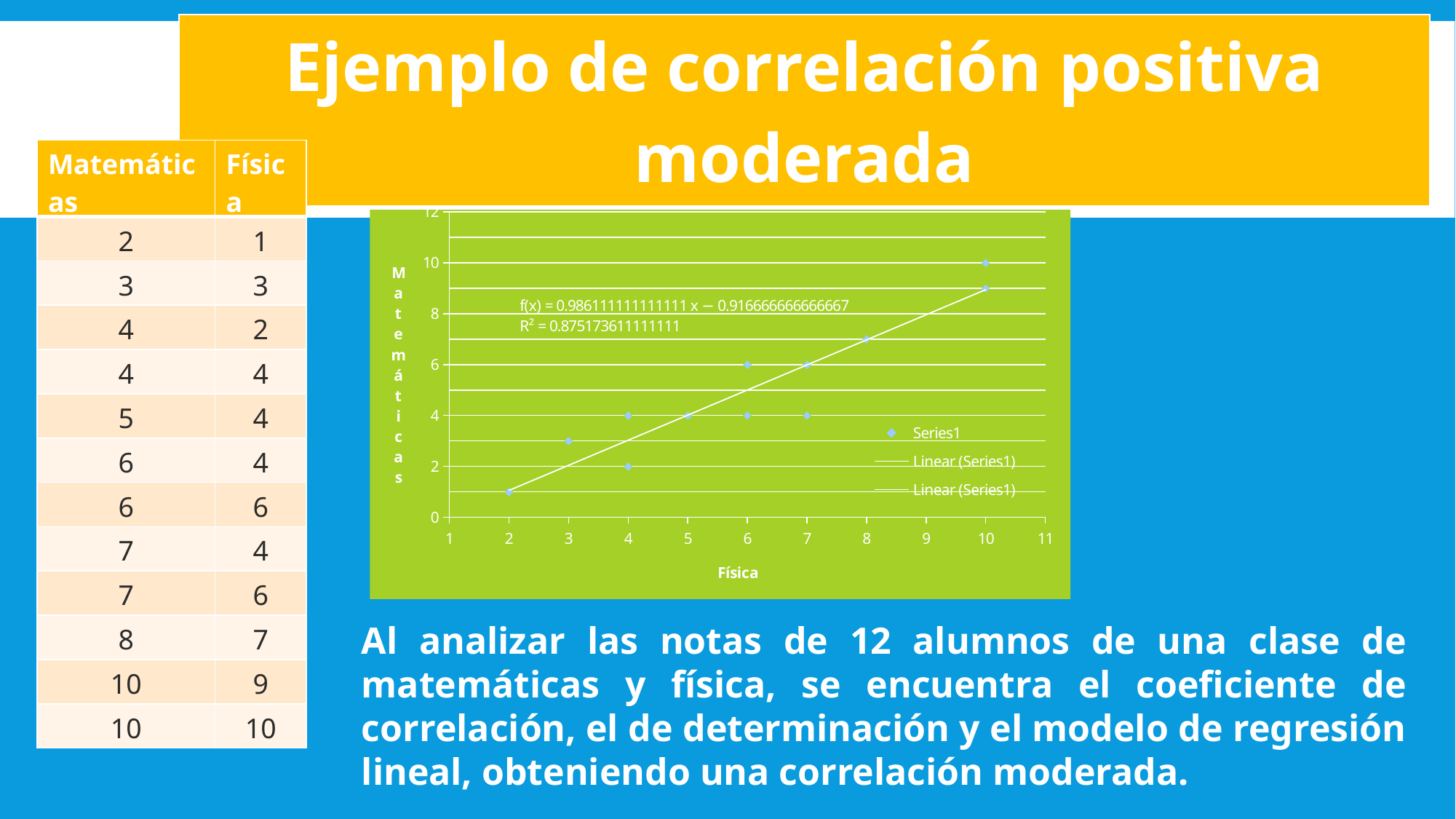
How many data points are plotted in the chart? 12 How many entries does the chart legend list? 3 Do the plotted values generally rise or fall as x increases along the x axis? rise What is the y value of the data point plotted at x = 3? 3 Which has the larger y value: the data point at x = 3 or the data point at x = 8? the point at x = 8 What is the y value of the data point plotted at x = 8? 7 What is the name of the data series in the chart legend? Series1 What is the R² value printed on the chart? 0.875173611111111 What is the title of the x axis of the chart? Física What is the lowest y value of any data point in the chart? 1 What kind of chart is shown on the slide? scatter chart What is the highest y value reached by any data point in the chart? 10